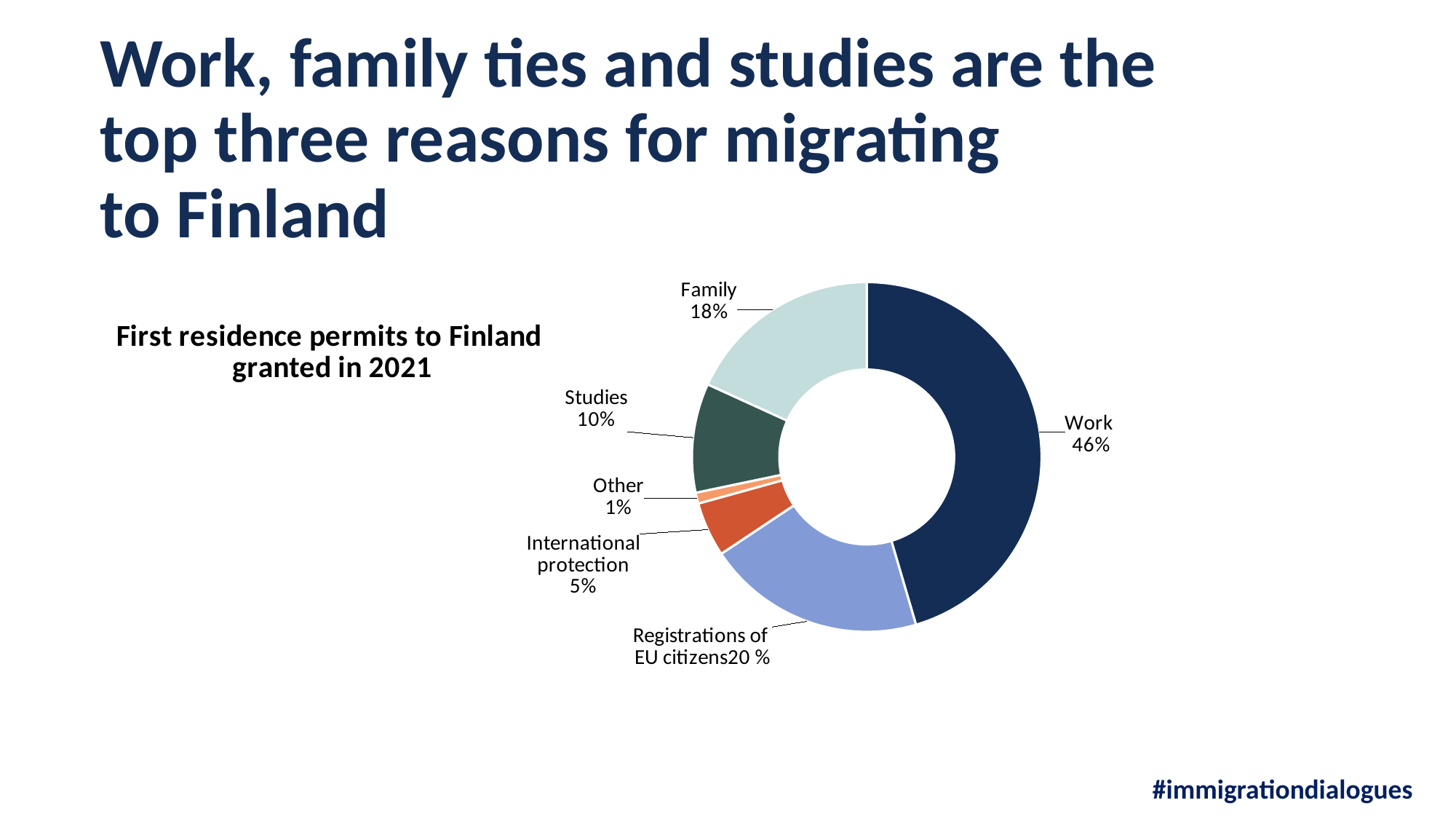
Which category has the largest share of the chart? Work What is the title of the chart? First residence permits to Finland granted in 2021 What percentage of the chart is labelled Family? 18% What is the value shown for Registrations of EU citizens? 20 % What is the difference in percentage points between Work and Family? 28 What percentage is shown for International protection? 5% What kind of chart is shown on the slide? Doughnut (pie) chart What share of first residence permits to Finland granted in 2021 was for Work? 46% Which is larger, the share for Studies or the share for International protection? Studies How many categories are shown in the chart? 6 What is the value shown for Studies? 10% Which category has the smallest share of the chart? Other